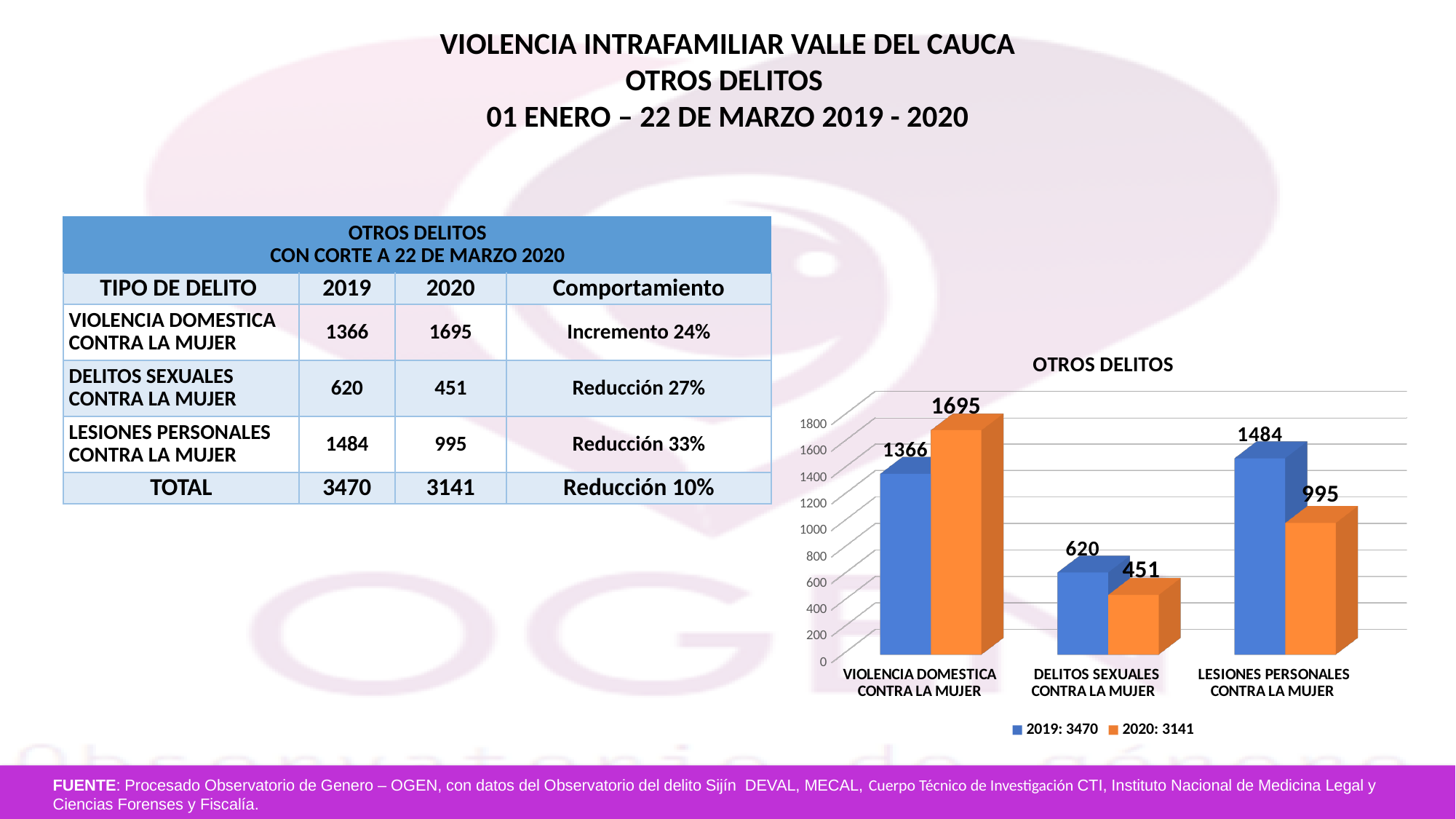
In the OTROS DELITOS chart, what is the 2020 value for LESIONES PERSONALES CONTRA LA MUJER? 995 In the OTROS DELITOS chart, what is the difference between the 2019 and 2020 values for LESIONES PERSONALES CONTRA LA MUJER? 489 In the OTROS DELITOS chart, is the 2019 value for LESIONES PERSONALES CONTRA LA MUJER greater or less than 1400? greater In the OTROS DELITOS chart, which category has the lowest 2019 value? DELITOS SEXUALES CONTRA LA MUJER What kind of chart is the OTROS DELITOS chart? Bar chart In the OTROS DELITOS chart, what is the difference between the 2020 and 2019 values for VIOLENCIA DOMESTICA CONTRA LA MUJER? 329 In the OTROS DELITOS chart, what is the 2019 value for VIOLENCIA DOMESTICA CONTRA LA MUJER? 1366 In the OTROS DELITOS chart, which is larger for DELITOS SEXUALES CONTRA LA MUJER, the 2019 value or the 2020 value? 2019 How many categories are shown on the x axis of the OTROS DELITOS chart? 3 In the OTROS DELITOS chart, which category has the highest 2020 value? VIOLENCIA DOMESTICA CONTRA LA MUJER In the OTROS DELITOS chart, what is the 2020 value for DELITOS SEXUALES CONTRA LA MUJER? 451 How many series does the legend of the OTROS DELITOS chart list? 2